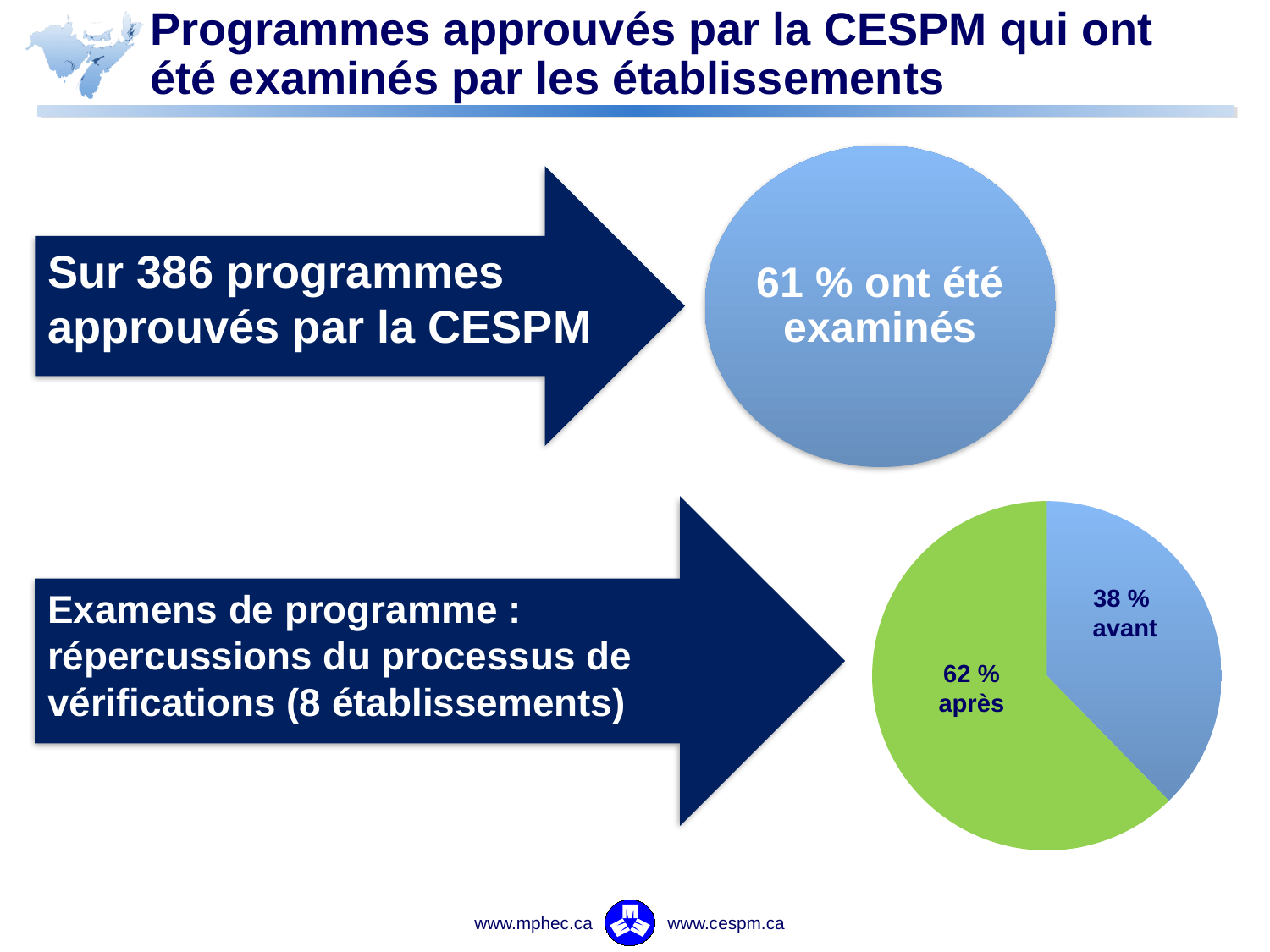
What kind of chart is shown at the bottom right of the slide? pie chart How many slices does the pie chart have? 2 In the pie chart, what share is labelled "avant"? 38 % In the pie chart, what is the difference in percentage points between the "après" slice and the "avant" slice? 24 % In the pie chart, is the "avant" share greater or less than 50 %? less What colour is the "avant" slice in the pie chart? blue In the pie chart, which is larger: the "avant" slice or the "après" slice? après Which slice of the pie chart is the smallest? avant In the pie chart, what share is labelled "après"? 62 % What colour is the "après" slice in the pie chart? green Which slice of the pie chart is the largest? après